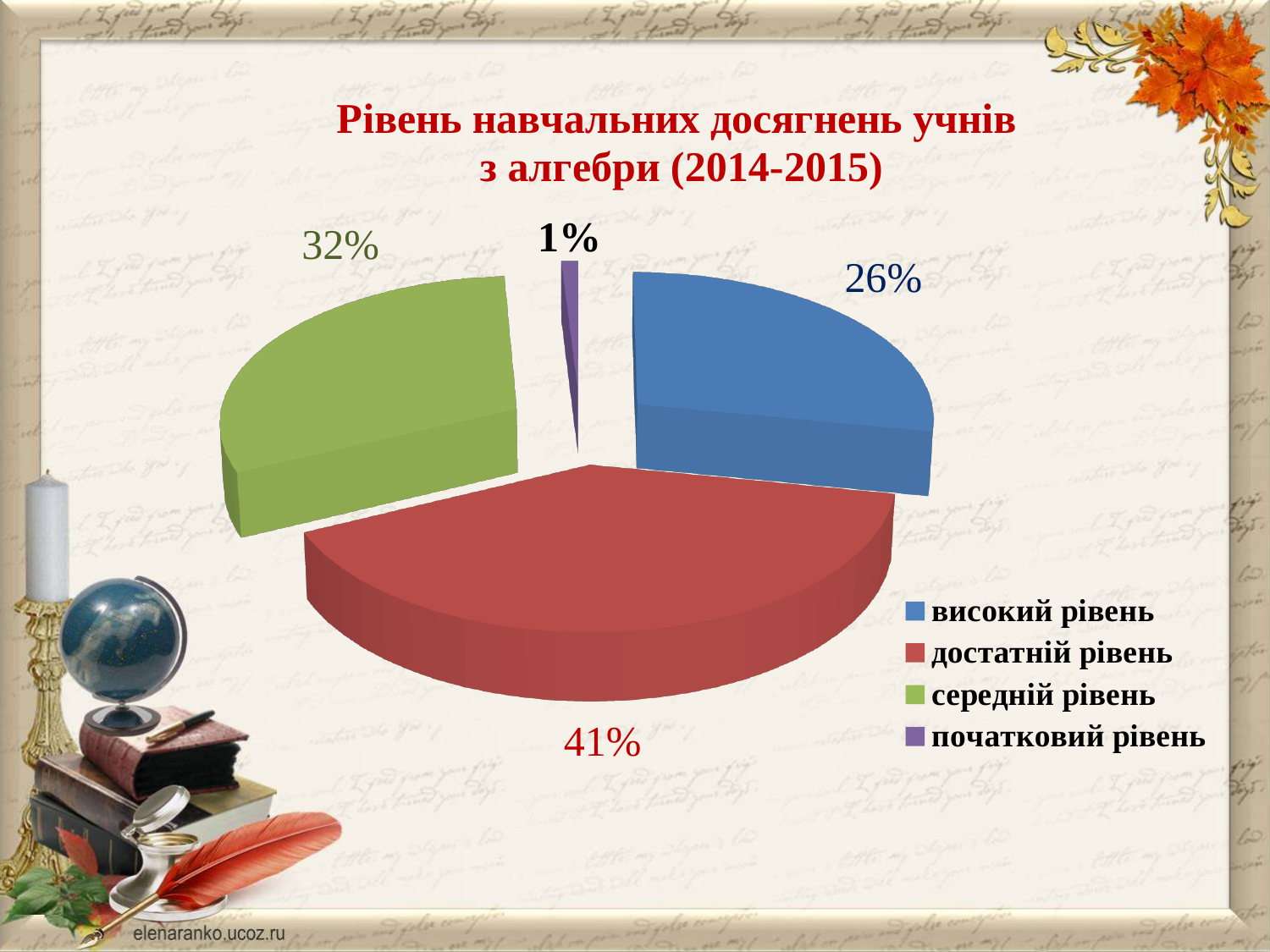
What is the difference in percentage points between "достатній рівень" and "високий рівень"? 15 Which is larger: the share for "середній рівень" or the share for "високий рівень"? середній рівень Which level has the largest slice of the pie? достатній рівень How many slices does the pie chart have? 4 What kind of chart is shown on the slide? pie chart What share of the pie does "середній рівень" have? 32% What share of the pie does "високий рівень" have? 26% What is the title of the chart? Рівень навчальних досягнень учнів з алгебри (2014-2015) What share of the pie does "достатній рівень" have? 41% Which level has the smallest slice of the pie? початковий рівень How many entries does the legend list? 4